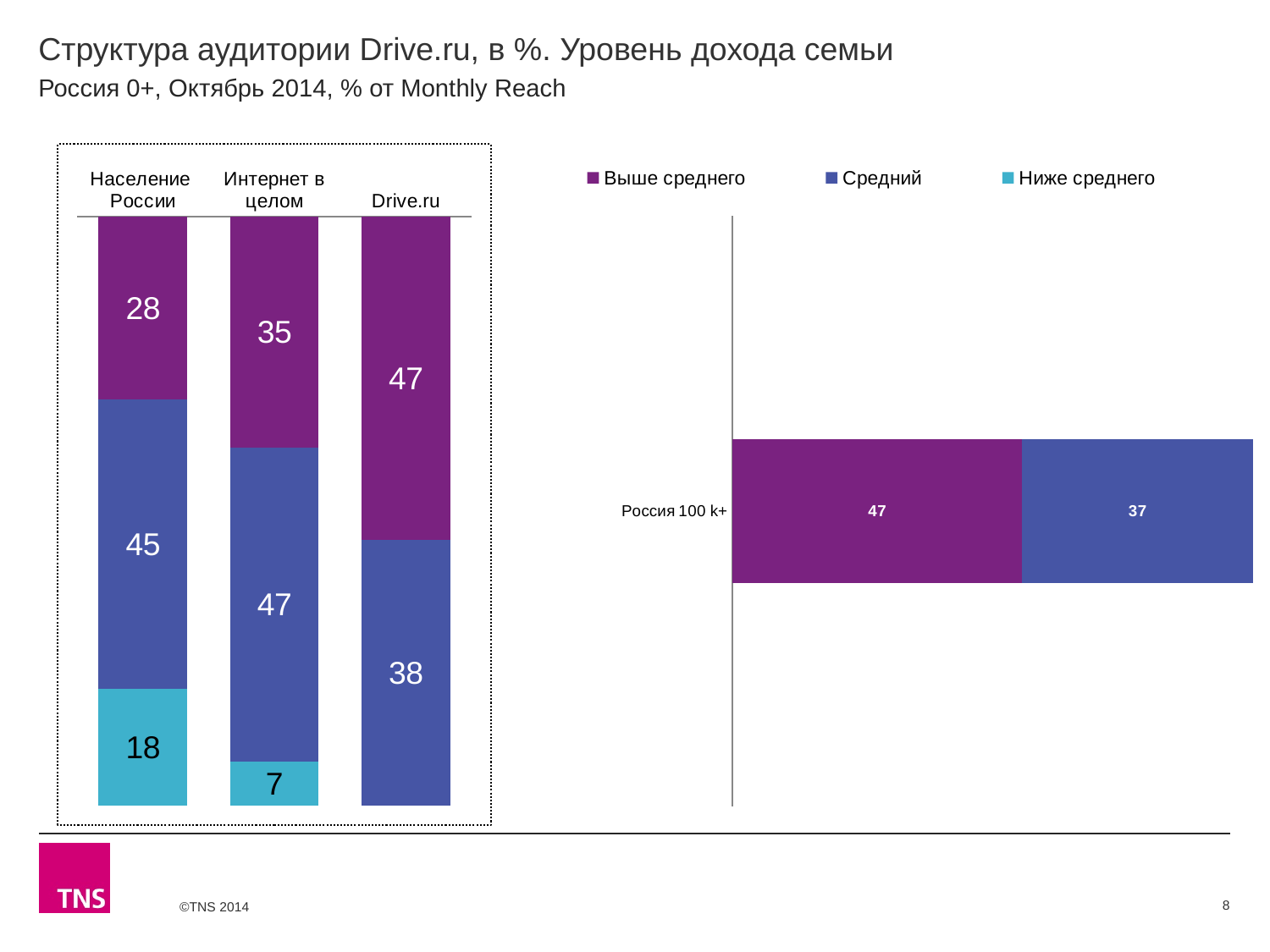
In the left stacked bar chart, what is the difference between the 'Выше среднего' values for Drive.ru and 'Население России'? 19 In the left stacked bar chart, is the 'Средний' value larger for 'Население России' or for Drive.ru? Население России In the left stacked bar chart, what is the value of the 'Средний' segment for 'Интернет в целом'? 47 What type of chart is the chart on the right of the slide? Bar chart How many series does the legend list? 3 How many categories are shown on the x axis of the left stacked bar chart? 3 In the left stacked bar chart, what is the value of the 'Выше среднего' segment for Drive.ru? 47 In the left stacked bar chart, which category has the highest 'Выше среднего' value? Drive.ru In the right chart, what is the total of the two labelled segments for 'Россия 100 k+'? 84 In the left stacked bar chart, what is the value of the 'Ниже среднего' segment for 'Население России'? 18 In the left stacked bar chart, which category has the lowest 'Ниже среднего' value among those with a labelled segment? Интернет в целом In the right chart, what is the value of the 'Средний' segment for 'Россия 100 k+'? 37